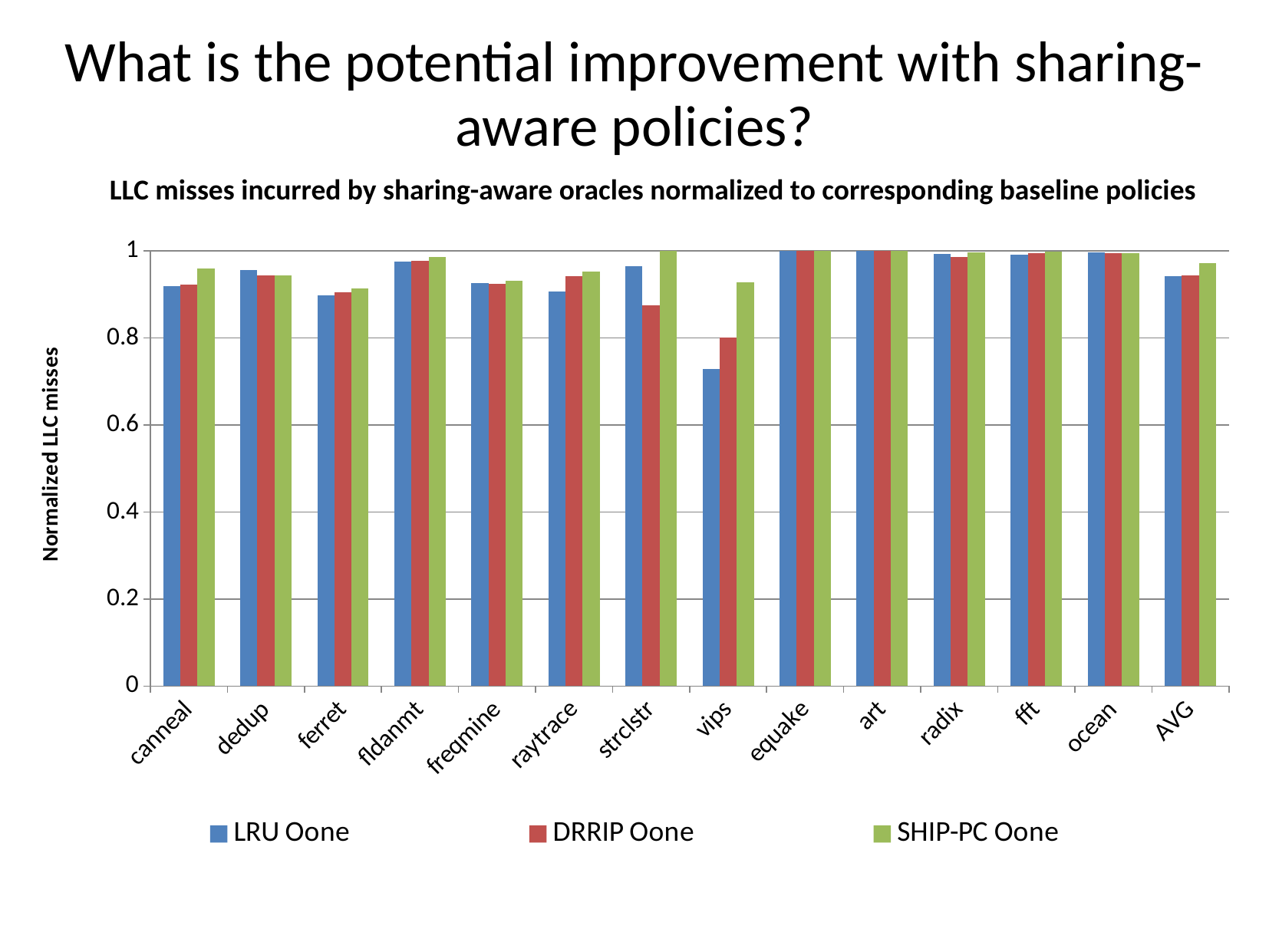
How many series does the legend list? 3 What kind of chart is shown on the slide? bar chart For vips, which is larger: the LRU Oone value or the SHIP-PC Oone value? SHIP-PC Oone How many categories are shown on the x axis? 14 What is the label of the y axis? Normalized LLC misses Which category has the lowest value for LRU Oone? vips For strclstr, which is larger: the DRRIP Oone value or the SHIP-PC Oone value? SHIP-PC Oone Is the LRU Oone value for vips greater or less than 0.8? less Which category has the lowest value for DRRIP Oone? vips What is the title of the chart? LLC misses incurred by sharing-aware oracles normalized to corresponding baseline policies